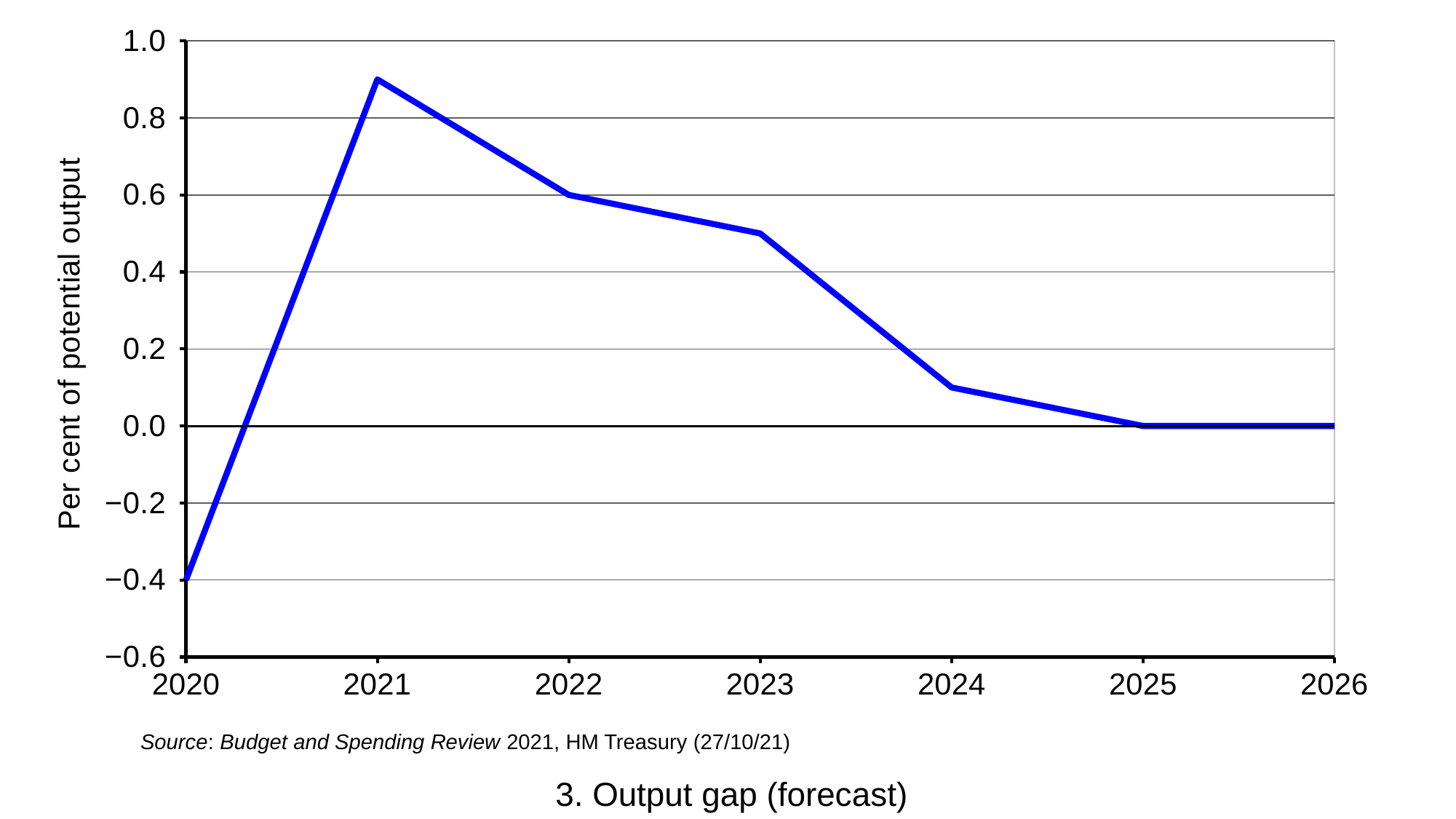
Does the output gap rise or fall between 2021 and 2025? fall What is the title of the chart? 3. Output gap (forecast) In which year is the output gap highest? 2021 Is the value for 2021 greater or less than 0.8? greater What is the output gap value for 2026? 0.0 What is the output gap value for 2020? -0.4 What is the output gap value for 2022? 0.6 What is the label on the vertical axis? Per cent of potential output What kind of chart is shown on the slide? line chart Is the value for 2024 greater or less than 0.2? less In which year is the output gap lowest? 2020 How many years are plotted on the x axis? 7